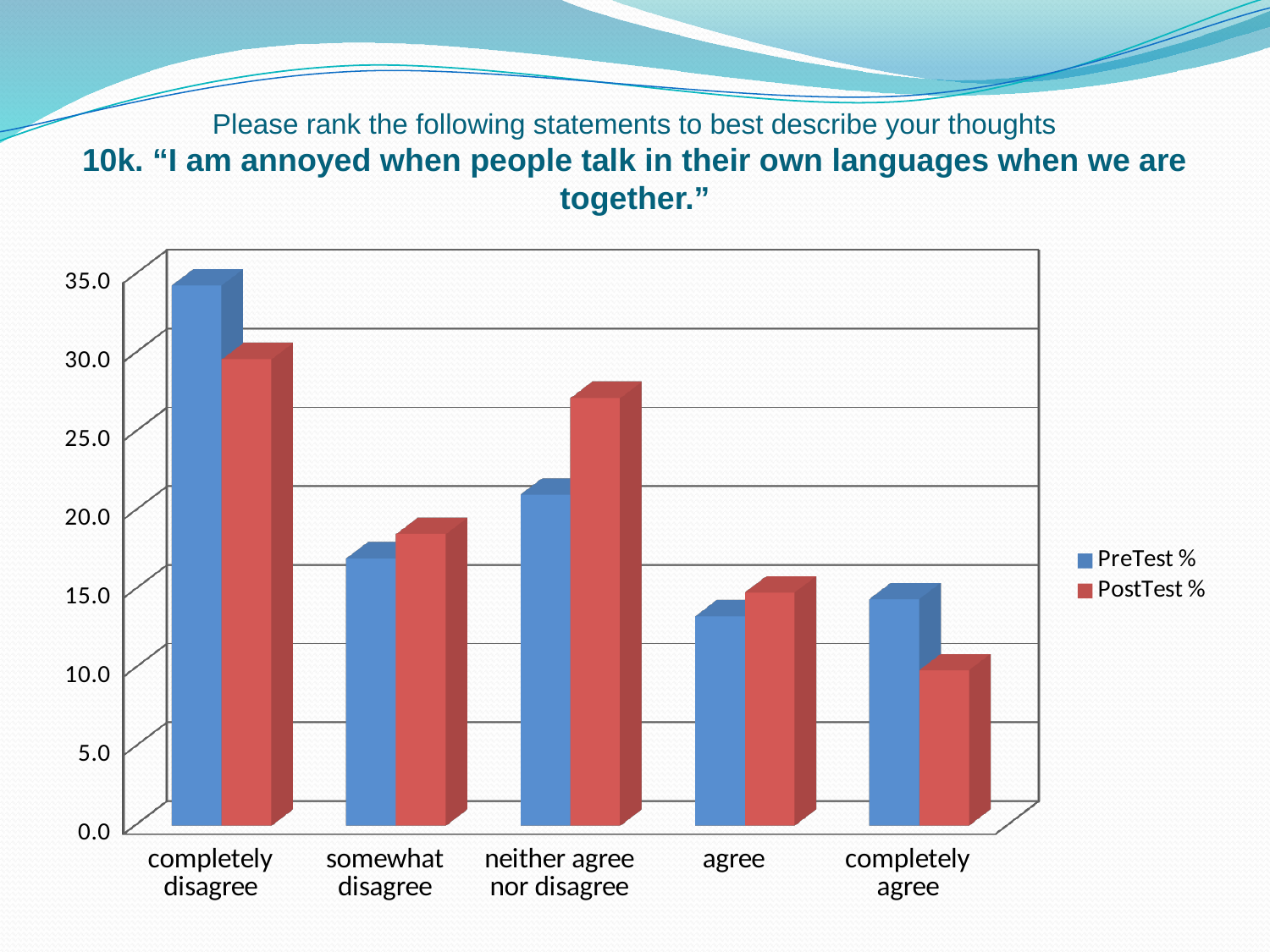
Is the PreTest % value for completely disagree greater or less than 30.0? greater Which category has the lowest PostTest % value? completely agree What colour are the PostTest % bars? red How many response categories are shown on the x axis? 5 Is the PostTest % value for neither agree nor disagree greater or less than 25.0? greater For completely agree, which is larger: PreTest % or PostTest %? PreTest % Which category has the highest PostTest % value? completely disagree What kind of chart is shown on the slide? bar chart For neither agree nor disagree, which is larger: PreTest % or PostTest %? PostTest % Which category has the highest PreTest % value? completely disagree How many series does the legend list? 2 Is the PostTest % value for completely agree greater or less than 15.0? less